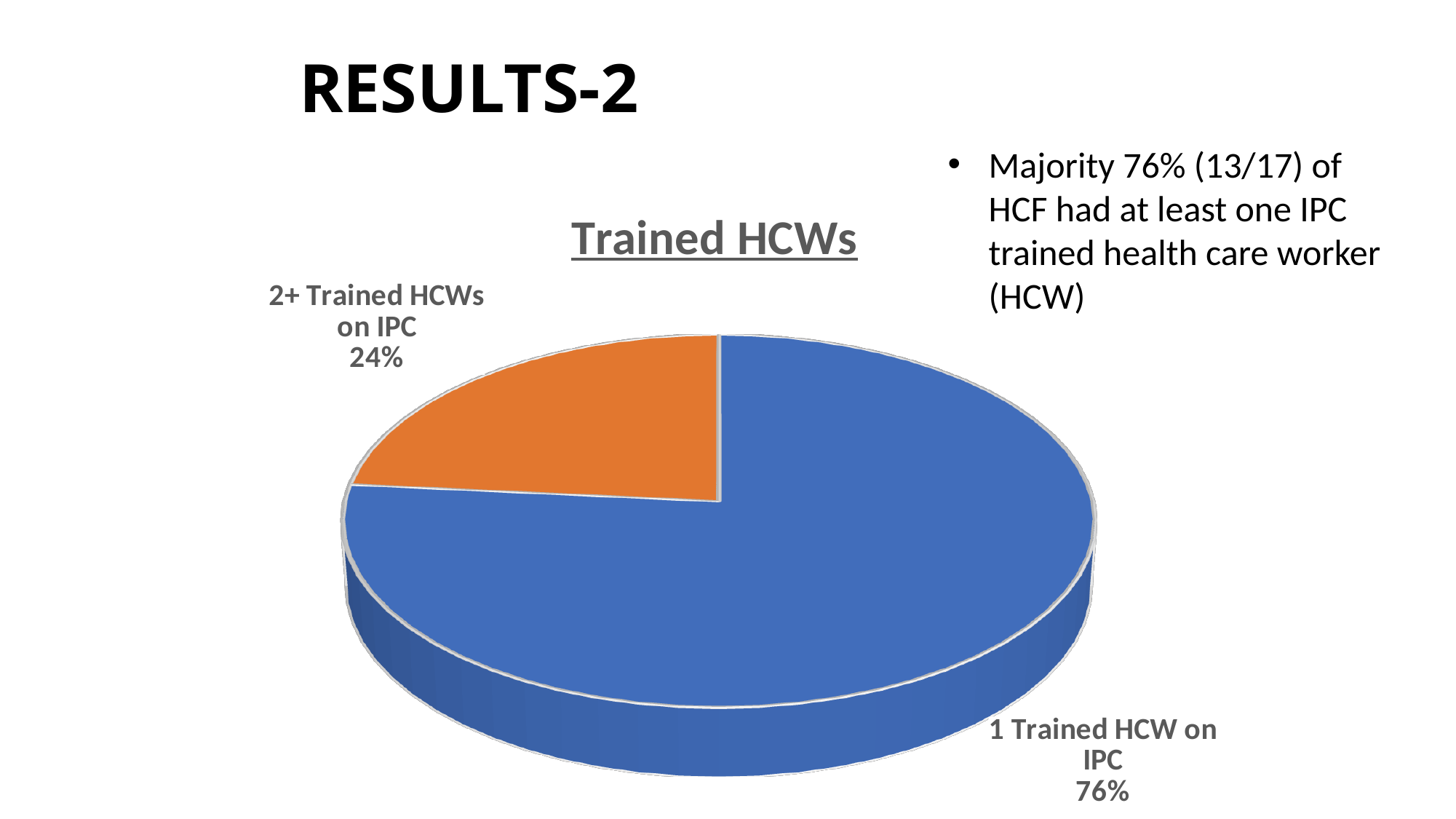
Is the share for "2+ Trained HCWs on IPC" greater or less than 50%? less What share of the pie is labelled "2+ Trained HCWs on IPC"? 24% Which slice of the pie is the smallest? 2+ Trained HCWs on IPC What share of the pie is labelled "1 Trained HCW on IPC"? 76% How many slices does the pie chart have? 2 Which is larger: the share for "1 Trained HCW on IPC" or the share for "2+ Trained HCWs on IPC"? 1 Trained HCW on IPC What is the title of the chart? Trained HCWs What kind of chart is shown on the slide? Pie chart What colour is the "2+ Trained HCWs on IPC" slice? Orange Which slice of the pie is the largest? 1 Trained HCW on IPC What is the difference in percentage points between the "1 Trained HCW on IPC" slice and the "2+ Trained HCWs on IPC" slice? 52 percentage points